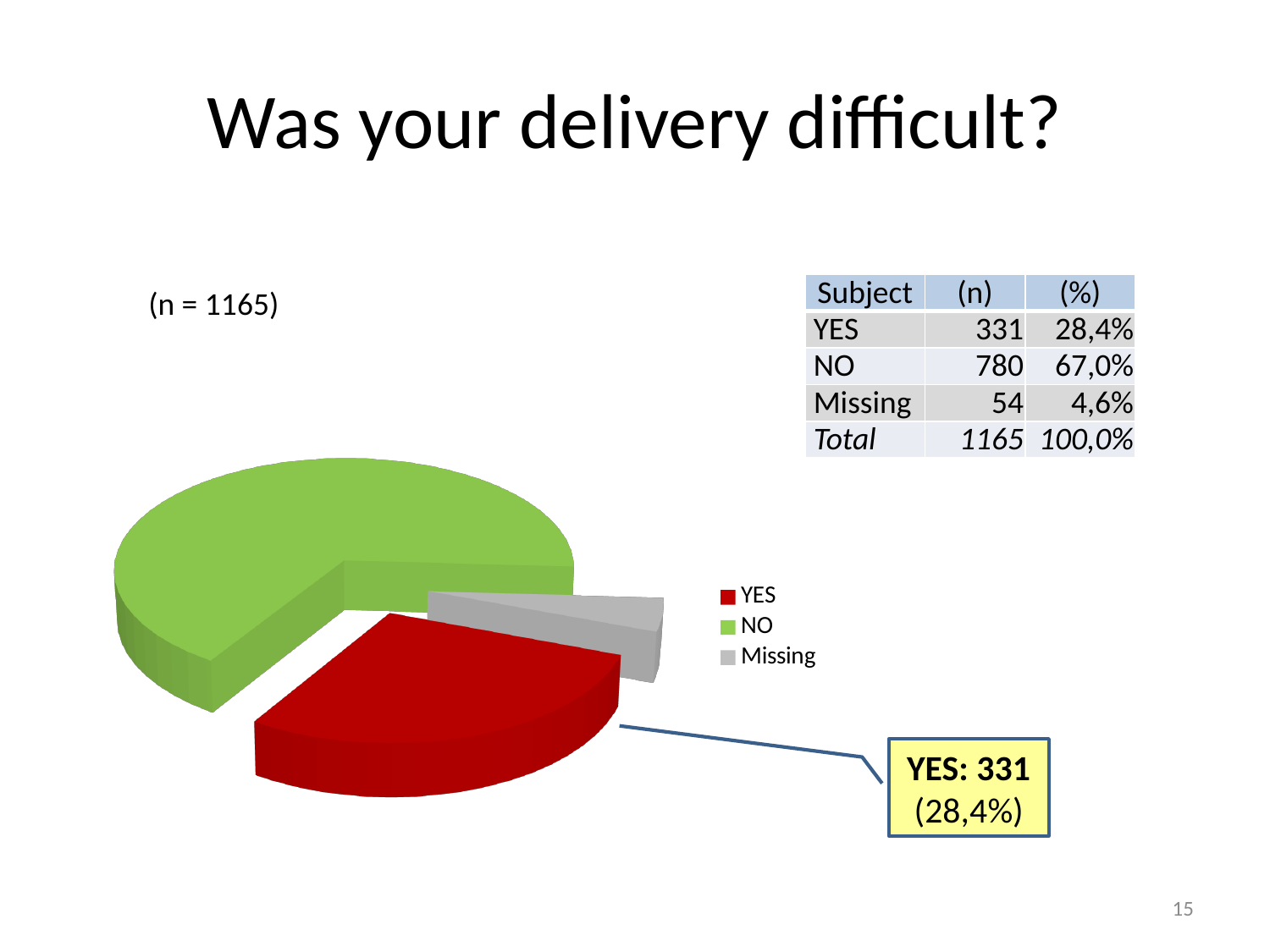
What is the count (n) for NO? 780 What is the difference in count between NO and YES? 449 Which colour represents the YES slice in the pie chart? red What percentage share does the NO slice have? 67,0% What is the count (n) for Missing? 54 Which category has the smallest slice? Missing What is the count (n) for YES? 331 What kind of chart is shown on the slide? pie chart How many slices does the pie chart have? 3 Which category has the largest slice? NO How many entries does the legend list? 3 What percentage share does the YES slice have? 28,4%